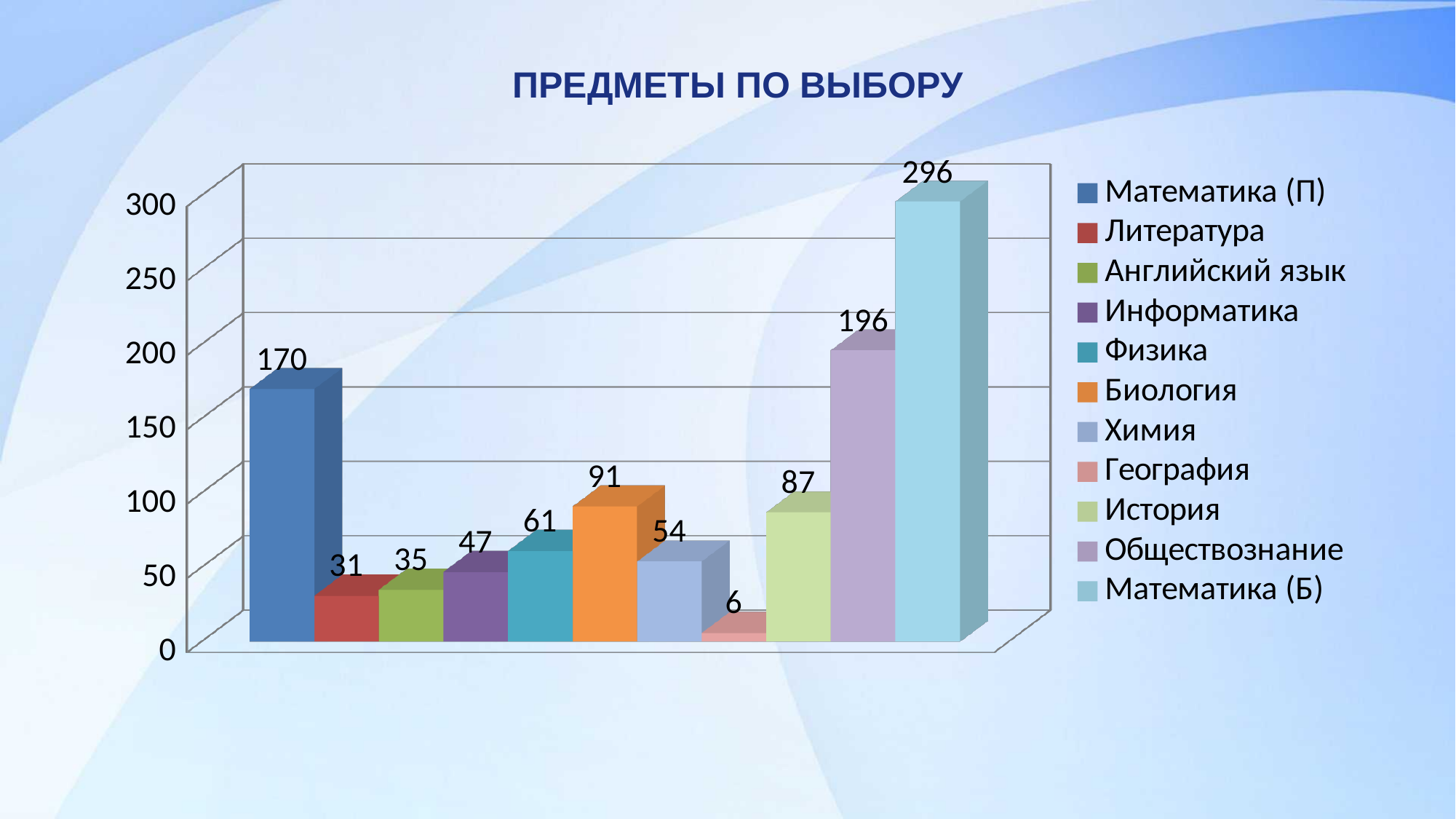
How many series does the legend list? 11 Which subject has the highest value? Математика (Б) What is the difference between Обществознание and История? 109 What is the title of the chart? ПРЕДМЕТЫ ПО ВЫБОРУ Which is larger, Физика or Химия? Физика Which subject has the lowest value? География What is the value for Математика (Б)? 296 What is the difference between Математика (Б) and Математика (П)? 126 What is the value for Биология? 91 What is the value for География? 6 What kind of chart is shown on the slide? bar chart Is the value for Математика (П) greater or less than 150? greater